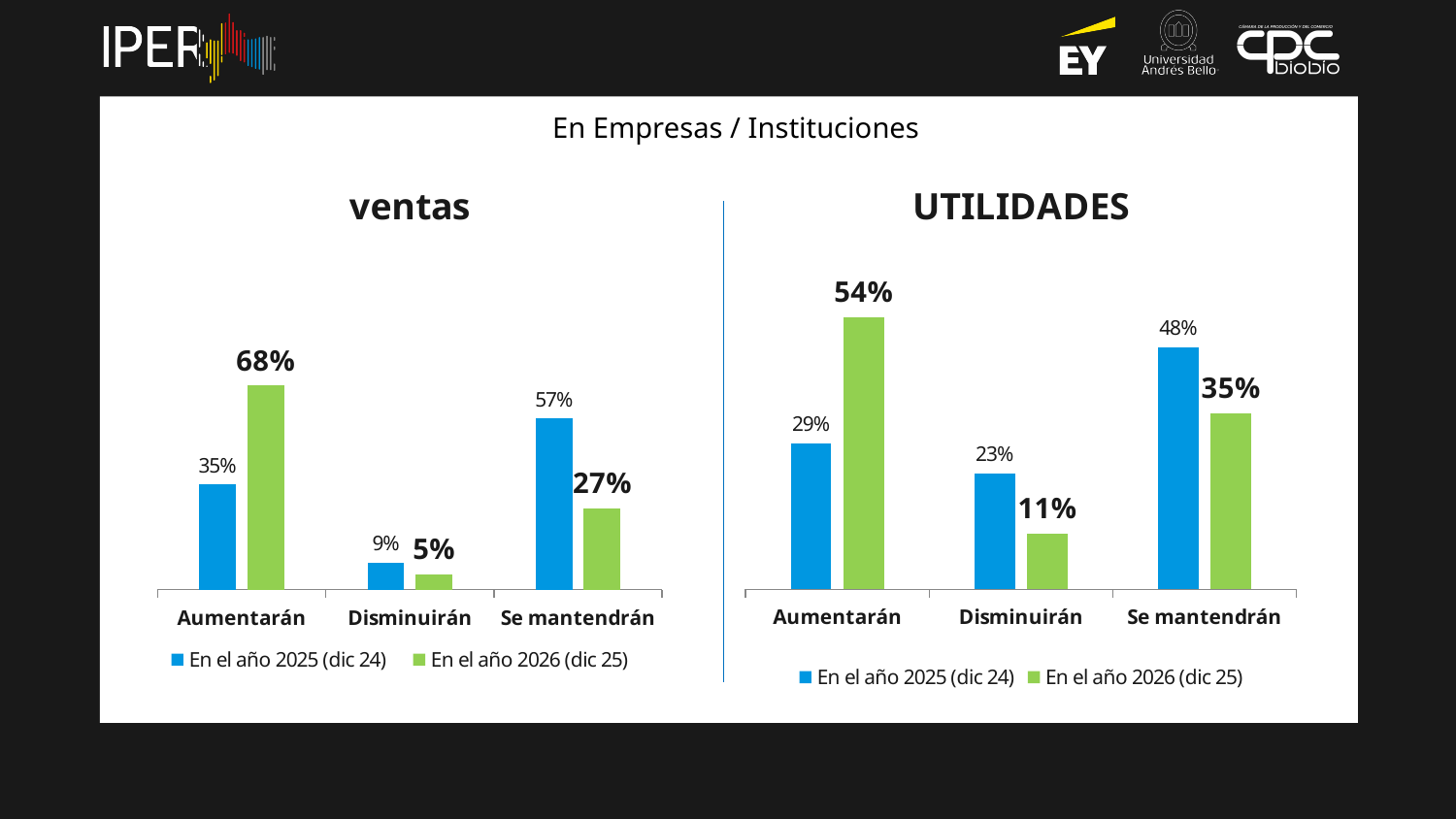
In the 'ventas' chart, what is the value for 'Se mantendrán' in the series 'En el año 2025 (dic 24)'? 57% In the 'UTILIDADES' chart, what is the value for 'Se mantendrán' in the series 'En el año 2025 (dic 24)'? 48% In the 'UTILIDADES' chart, which is larger for 'Disminuirán': the 2025 (dic 24) value or the 2026 (dic 25) value? En el año 2025 (dic 24) What kind of chart is the 'ventas' chart? Bar chart In the 'UTILIDADES' chart, what is the difference between the 2025 (dic 24) and 2026 (dic 25) values for 'Se mantendrán'? 13 percentage points How many series does the legend of the 'UTILIDADES' chart list? 2 In the 'ventas' chart, what is the value for 'Aumentarán' in the series 'En el año 2026 (dic 25)'? 68% In the 'ventas' chart, what is the difference between the 2026 (dic 25) and 2025 (dic 24) values for 'Aumentarán'? 33 percentage points In the 'UTILIDADES' chart, what is the value for 'Disminuirán' in the series 'En el año 2026 (dic 25)'? 11% How many categories are shown on the x axis of the 'ventas' chart? 3 In the 'UTILIDADES' chart, which category has the highest value for the series 'En el año 2026 (dic 25)'? Aumentarán In the 'ventas' chart, which category has the lowest value for the series 'En el año 2026 (dic 25)'? Disminuirán